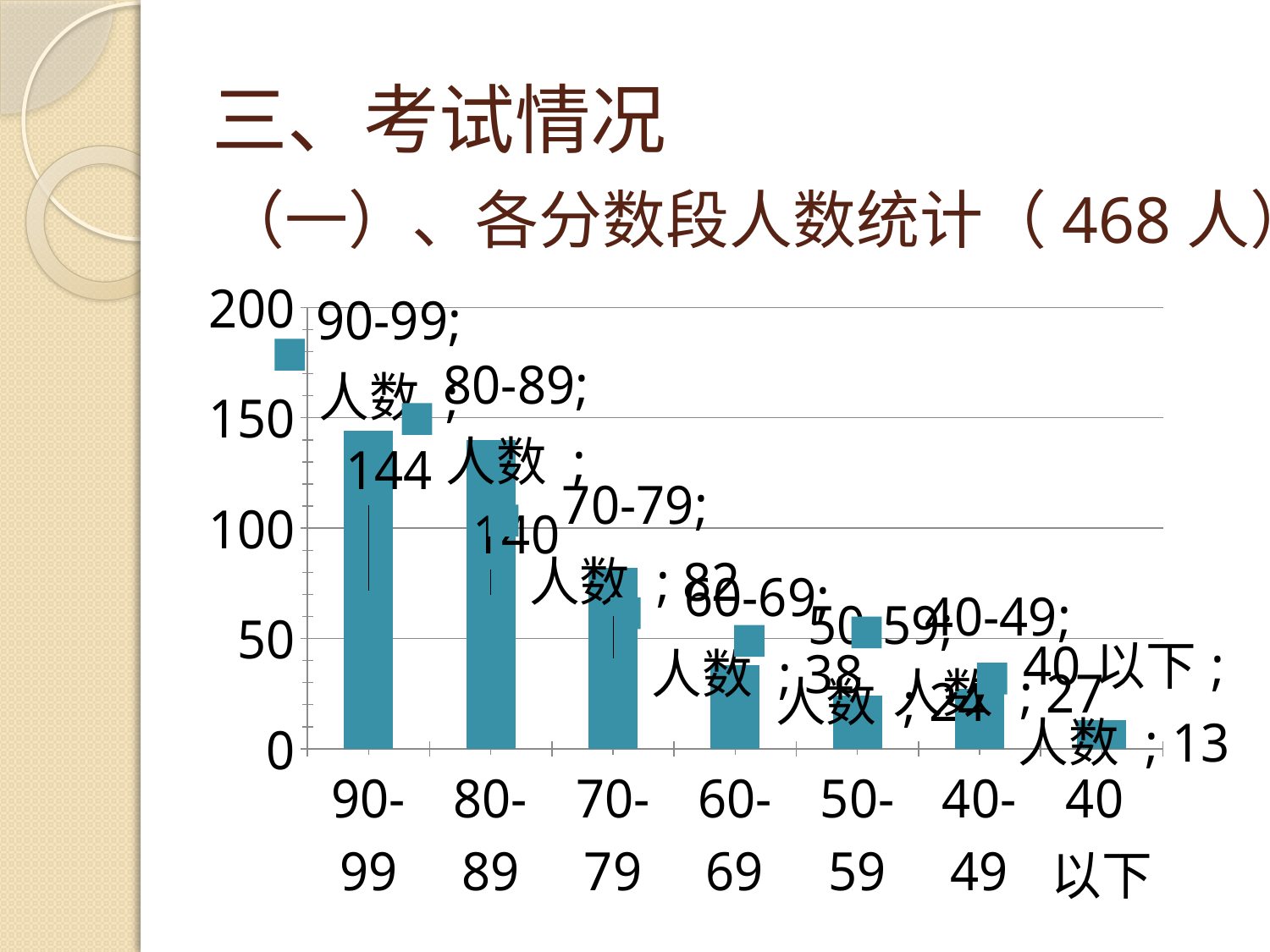
Which score range has the highest number of people? 90-99 Is the value for the 70-79 range greater or less than 100? less What is the number of people (人数) in the 80-89 score range? 140 What total number of people is stated in the slide's subtitle for the score distribution? 468 人 Which has more people, the 60-69 range or the 40-49 range? 60-69 What is the number of people (人数) in the 90-99 score range? 144 What is the number of people (人数) in the 40以下 (below 40) score range? 13 Which score range has the lowest number of people? 40以下 How many score-range categories are plotted on the x axis? 7 What is the number of people (人数) in the 70-79 score range? 82 What kind of chart is shown on the slide? bar chart What is the difference between the number of people in the 90-99 range and the 70-79 range? 62